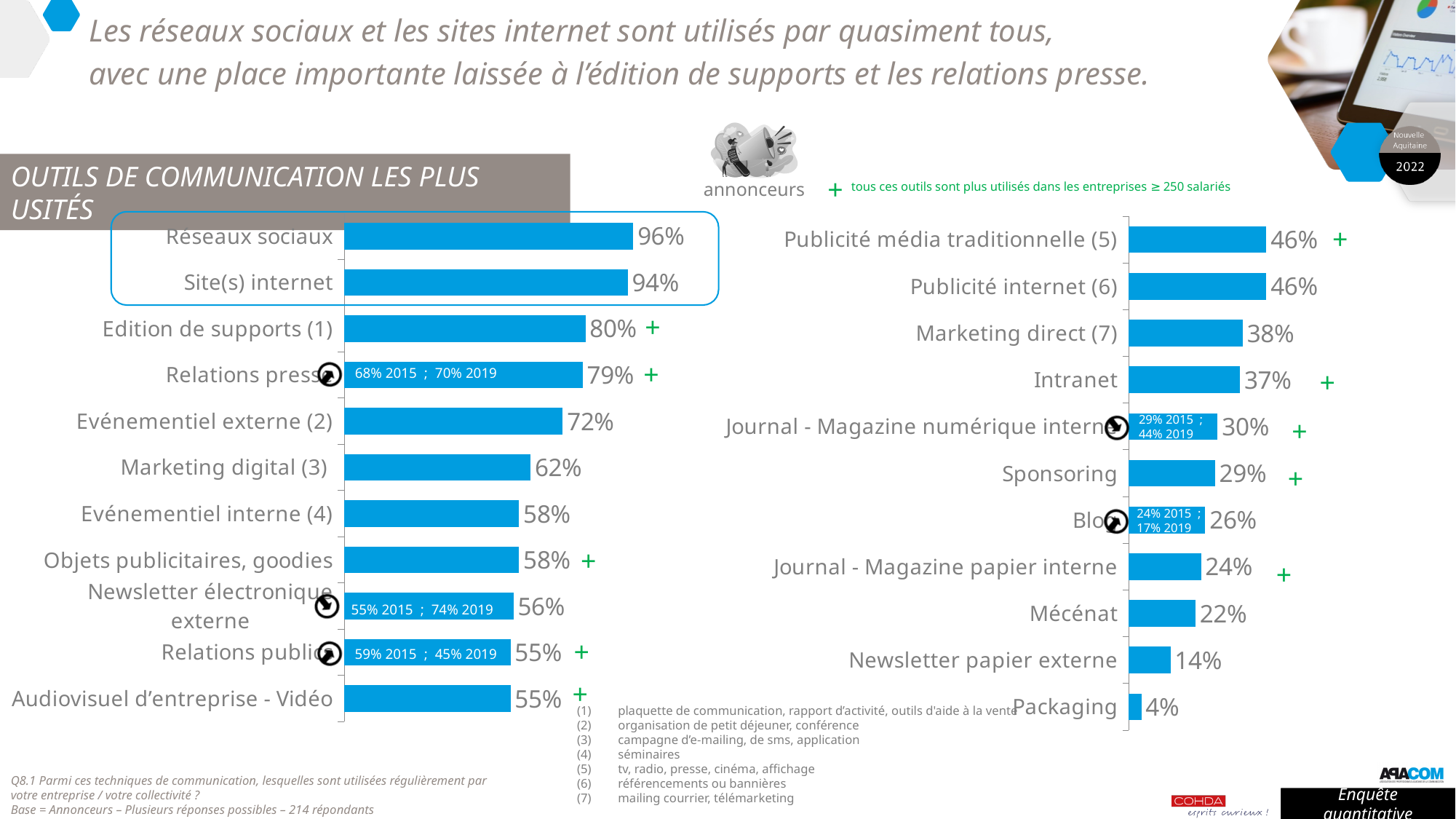
In the right chart, what is the value for Packaging? 4% In the left chart, what is the difference between Réseaux sociaux and Site(s) internet? 2% In the right chart, which category has the lowest value? Packaging In the left chart, what is the value for Evénementiel externe (2)? 72% In the right chart, which is larger: Sponsoring or Newsletter papier externe? Sponsoring In the right chart, what is the value for Intranet? 37% In the left chart, what is the value for Réseaux sociaux? 96% In the right chart, what is the difference between Marketing direct (7) and Mécénat? 16% How many categories are shown in the right chart? 11 In the left chart, which category has the highest value? Réseaux sociaux In the left chart, what is the value for Marketing digital (3)? 62% What type of chart is the left chart? Bar chart